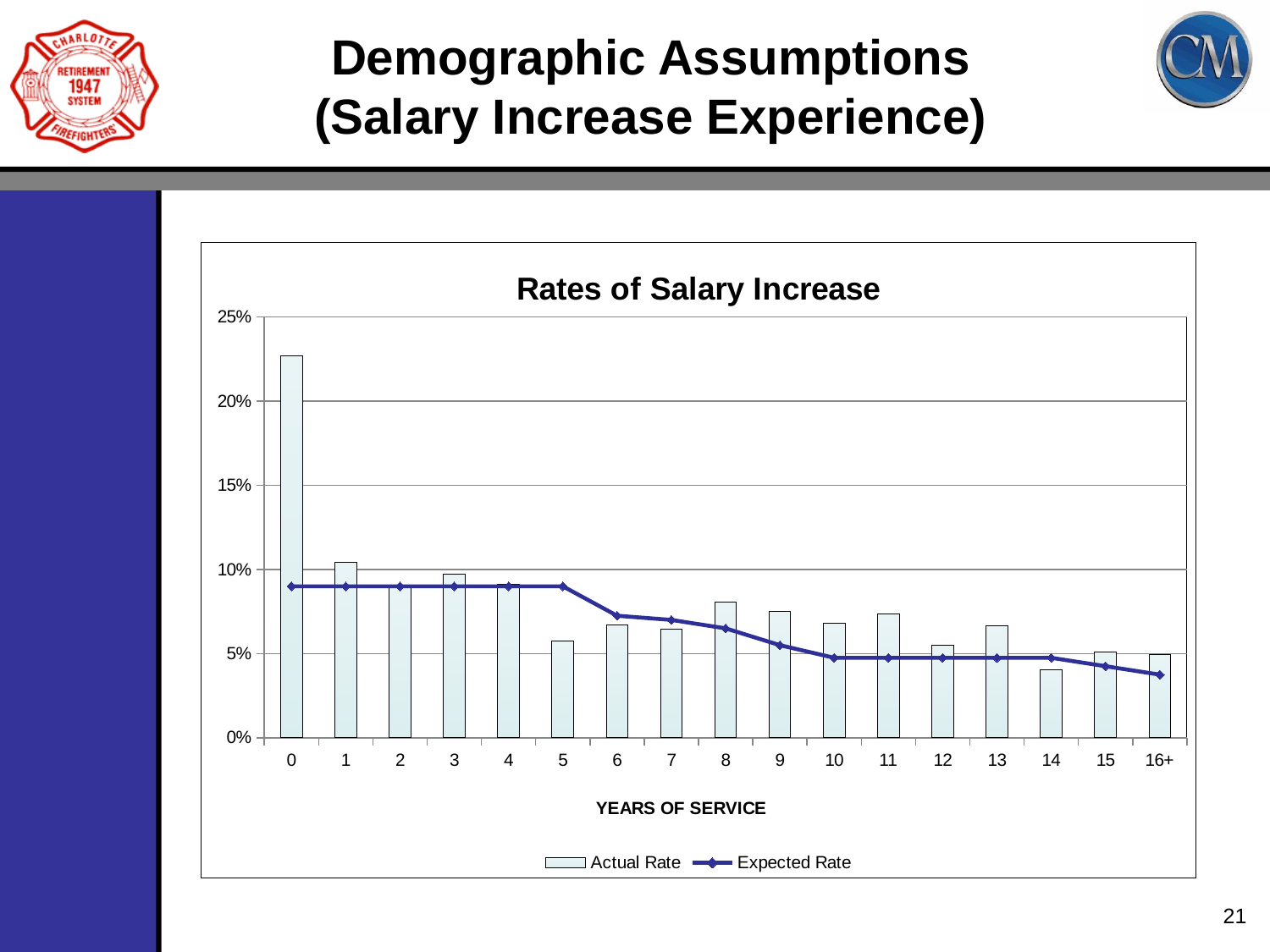
Which years-of-service category has the highest Actual Rate? 0 Is the Expected Rate for 0 years of service greater or less than 10%? less Is the Actual Rate for 0 years of service greater or less than 20%? greater At 5 years of service, which is larger, the Actual Rate or the Expected Rate? Expected Rate How many years-of-service categories are shown on the x axis? 17 How many series does the legend list? 2 What is the title of the chart? Rates of Salary Increase Does the Expected Rate generally rise or fall as years of service increase? fall Is the Actual Rate for 14 years of service greater or less than 5%? less Which years-of-service category has the lowest Actual Rate? 14 What kind of chart is used to show the Actual Rate series? bar chart At 0 years of service, which is larger, the Actual Rate or the Expected Rate? Actual Rate